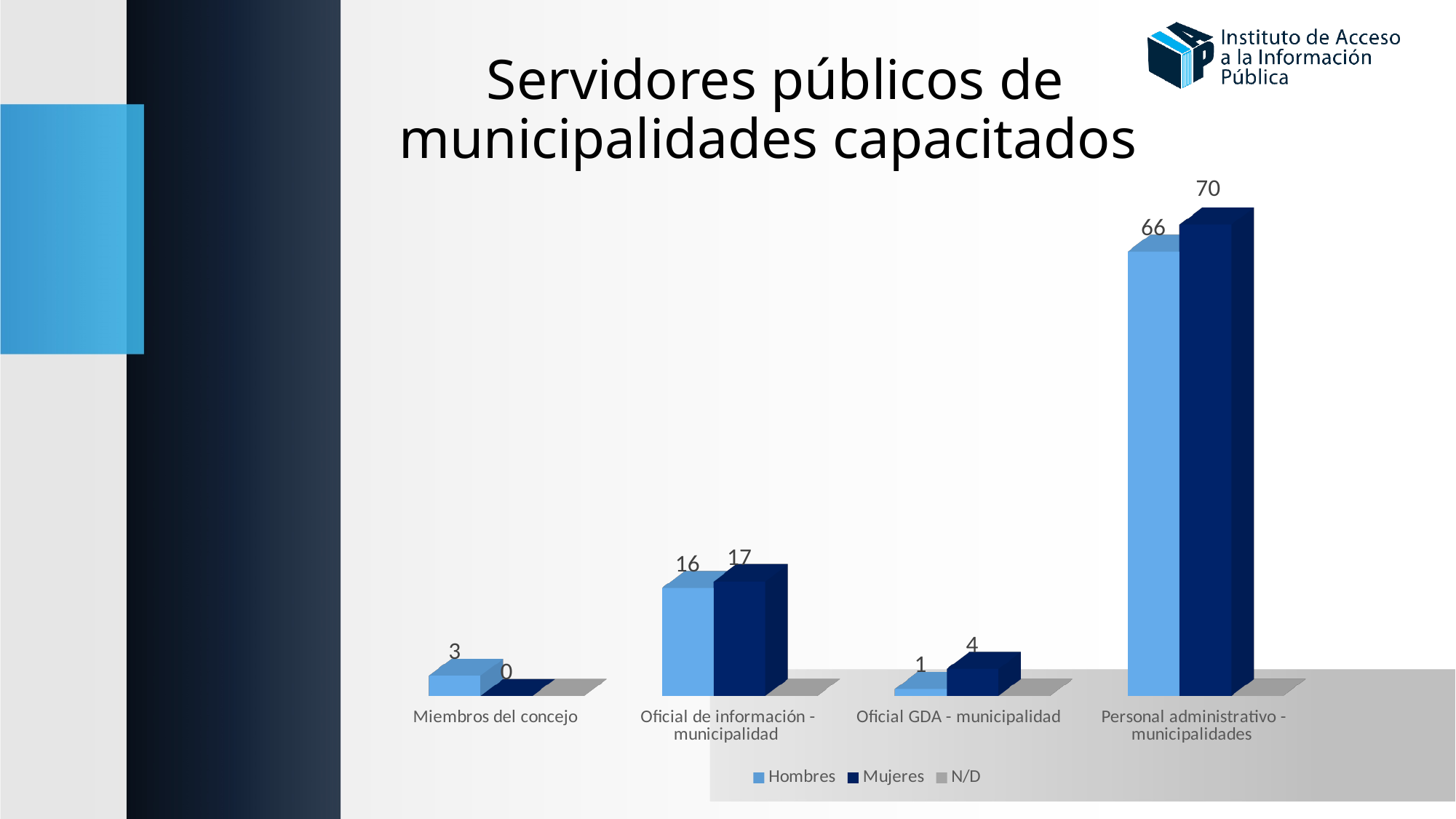
What is the title of the chart on the slide? Servidores públicos de municipalidades capacitados What kind of chart is shown on the slide? Bar chart What is the value for Mujeres in the Oficial de información - municipalidad category? 17 What is the value for Hombres in the Personal administrativo - municipalidades category? 66 How many series does the legend list? 3 Which is larger in the Oficial GDA - municipalidad category, Hombres or Mujeres? Mujeres What is the value for Mujeres in the Miembros del concejo category? 0 Which category has the lowest value for Hombres? Oficial GDA - municipalidad What is the value for Hombres in the Oficial GDA - municipalidad category? 1 What is the difference between the Mujeres and Hombres values in the Personal administrativo - municipalidades category? 4 Which category has the highest value for Mujeres? Personal administrativo - municipalidades How many categories are shown on the x axis? 4